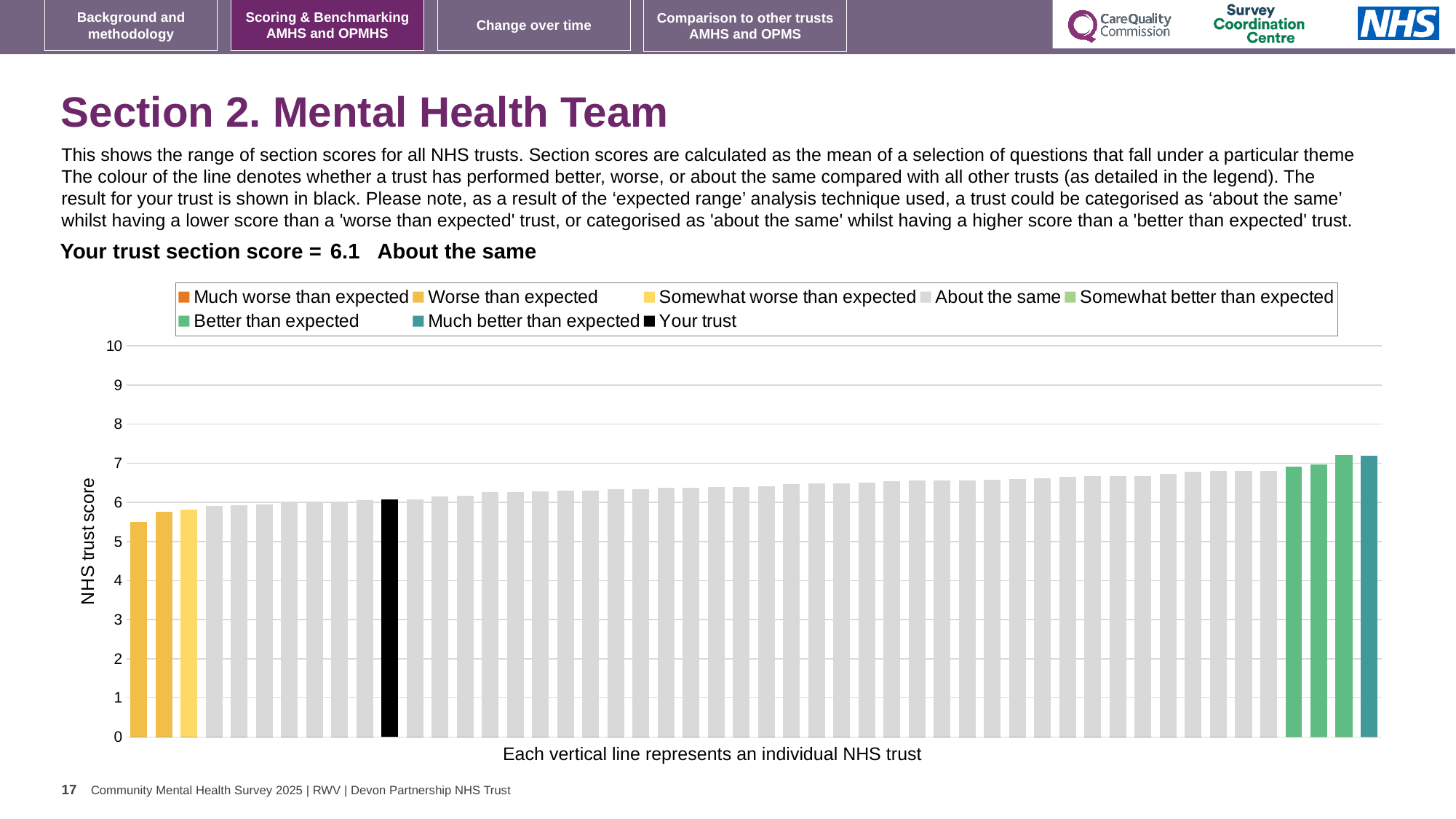
Is the value of the lowest bar in the chart greater or less than 6? less According to the slide, which category is your trust's section score placed in? About the same Do the bar values rise or fall from left to right along the x axis? rise Is the value for your trust (the black bar) greater or less than 5? greater Is the value of the highest bar in the chart greater or less than 6? greater What colour is used for the 'Your trust' bar in the chart? black What is the label on the y axis of the chart? NHS trust score How many entries does the chart legend list? 8 What kind of chart is shown on the slide? bar chart What is the section score for your trust shown on the slide? 6.1